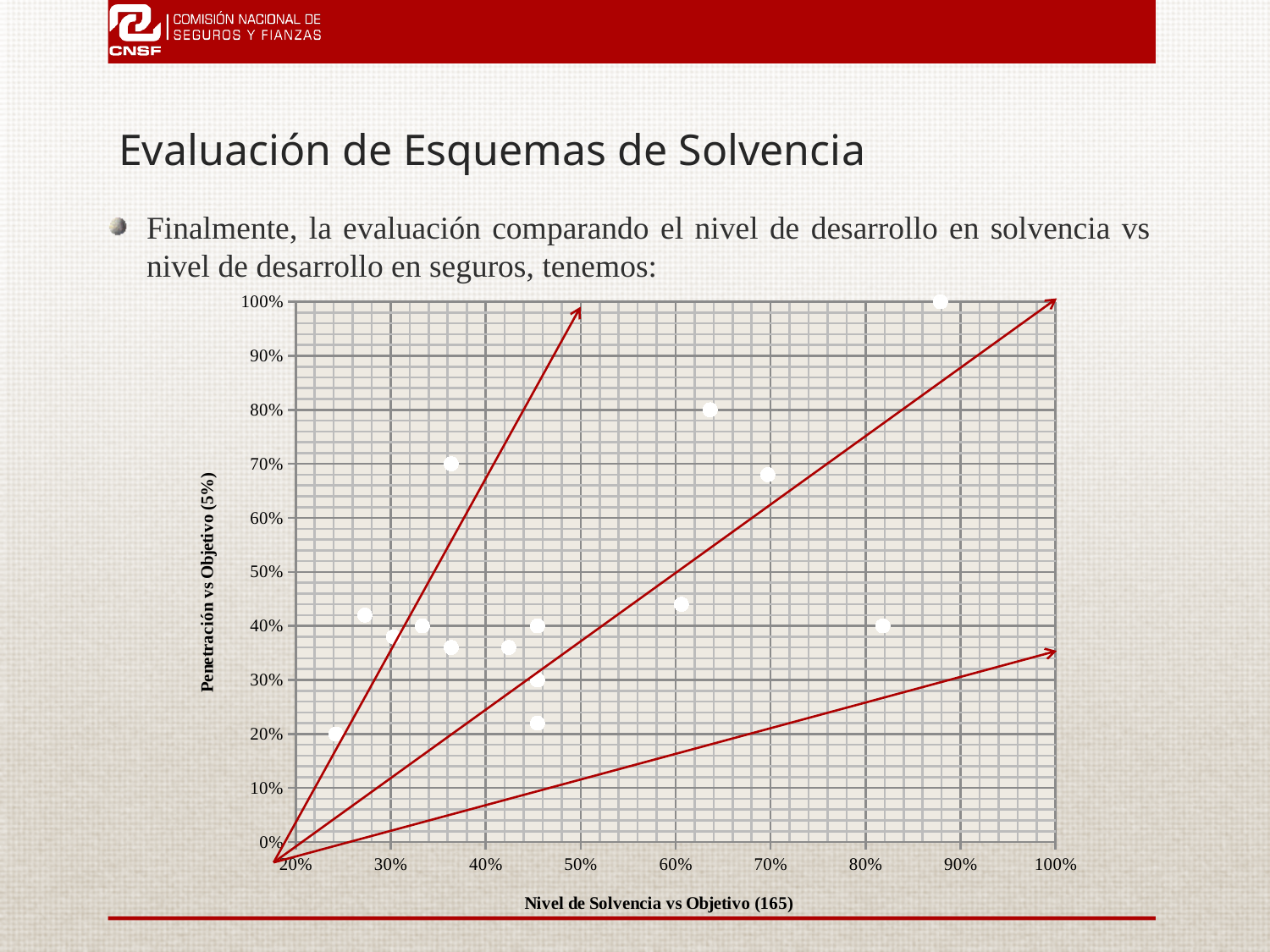
What is the title of the x axis of the chart? Nivel de Solvencia vs Objetivo (165) Is the Nivel de Solvencia vs Objetivo value of the point with 70% Penetración greater or less than 50%? less Which is larger: the Penetración vs Objetivo value of the point at about 63% Nivel de Solvencia or the point at about 70% Nivel de Solvencia? the point at about 63% What is the title of the y axis of the chart? Penetración vs Objetivo (5%) What kind of chart is shown on the slide? scatter chart How many points on the chart have a Penetración vs Objetivo value above 60%? 4 Is the Nivel de Solvencia vs Objetivo value of the point with 80% Penetración greater or less than 50%? greater How many data points are plotted on the chart? 15 Is the Nivel de Solvencia vs Objetivo value of the point with 100% Penetración greater or less than 80%? greater What is the highest Penetración vs Objetivo value reached by any point on the chart? 100% What is the lowest Penetración vs Objetivo value reached by any point on the chart? 20%